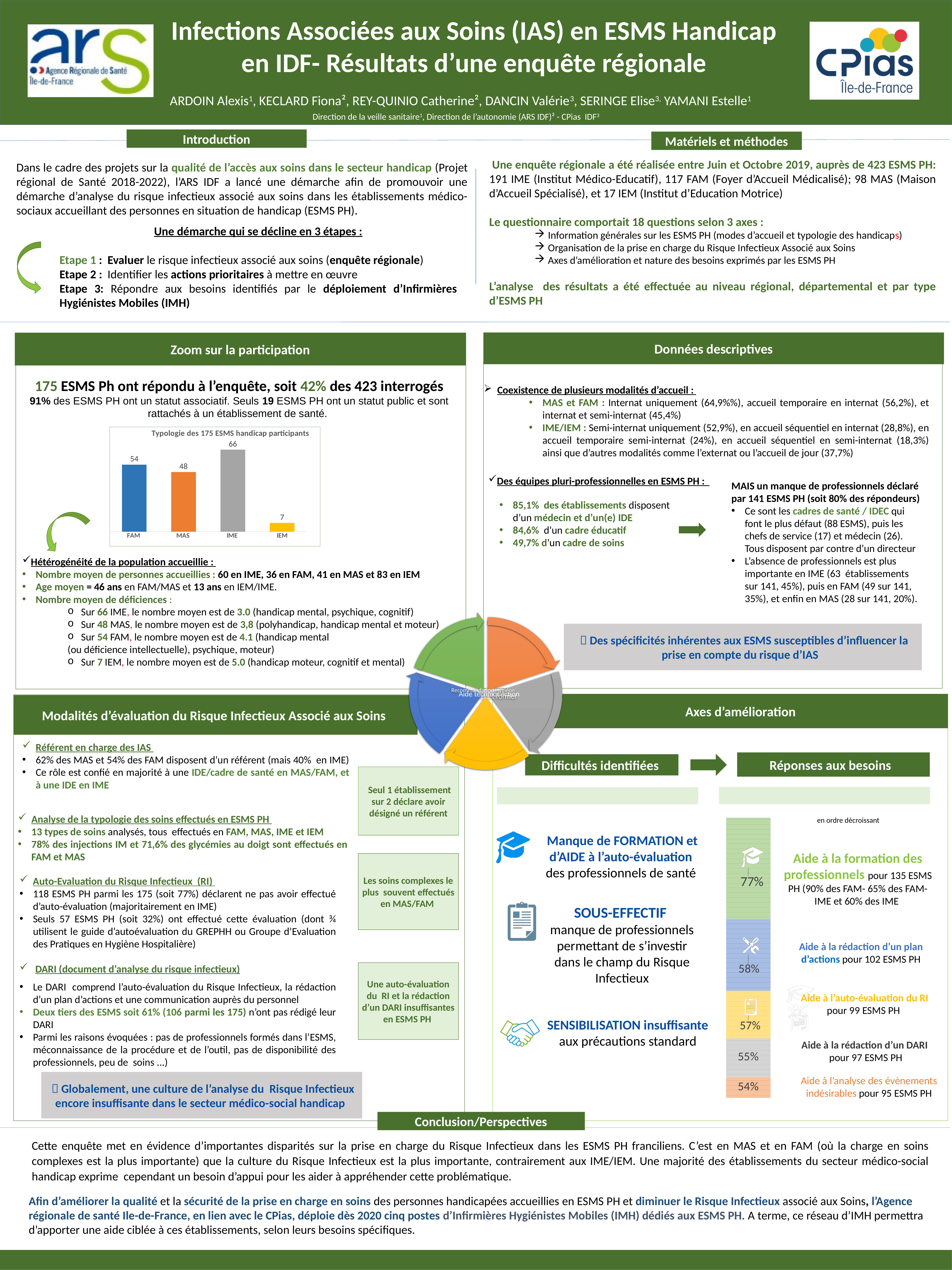
In the chart titled 'Typologie des 175 ESMS handicap participants', what is the difference between the values for FAM and MAS? 6 In the chart titled 'Typologie des 175 ESMS handicap participants', which is larger, the value for FAM or the value for MAS? FAM What kind of chart is the one titled 'Typologie des 175 ESMS handicap participants'? Bar chart In the chart titled 'Typologie des 175 ESMS handicap participants', which category has the highest value? IME In the chart titled 'Typologie des 175 ESMS handicap participants', what colour is the bar for IME? Grey In the chart titled 'Typologie des 175 ESMS handicap participants', what is the value for IEM? 7 In the chart titled 'Typologie des 175 ESMS handicap participants', what is the value for MAS? 48 In the chart titled 'Typologie des 175 ESMS handicap participants', which category has the lowest value? IEM In the chart titled 'Typologie des 175 ESMS handicap participants', what is the value for FAM? 54 In the chart titled 'Typologie des 175 ESMS handicap participants', what is the value for IME? 66 In the chart titled 'Typologie des 175 ESMS handicap participants', what is the difference between the values for IME and FAM? 12 How many categories are shown in the chart titled 'Typologie des 175 ESMS handicap participants'? 4